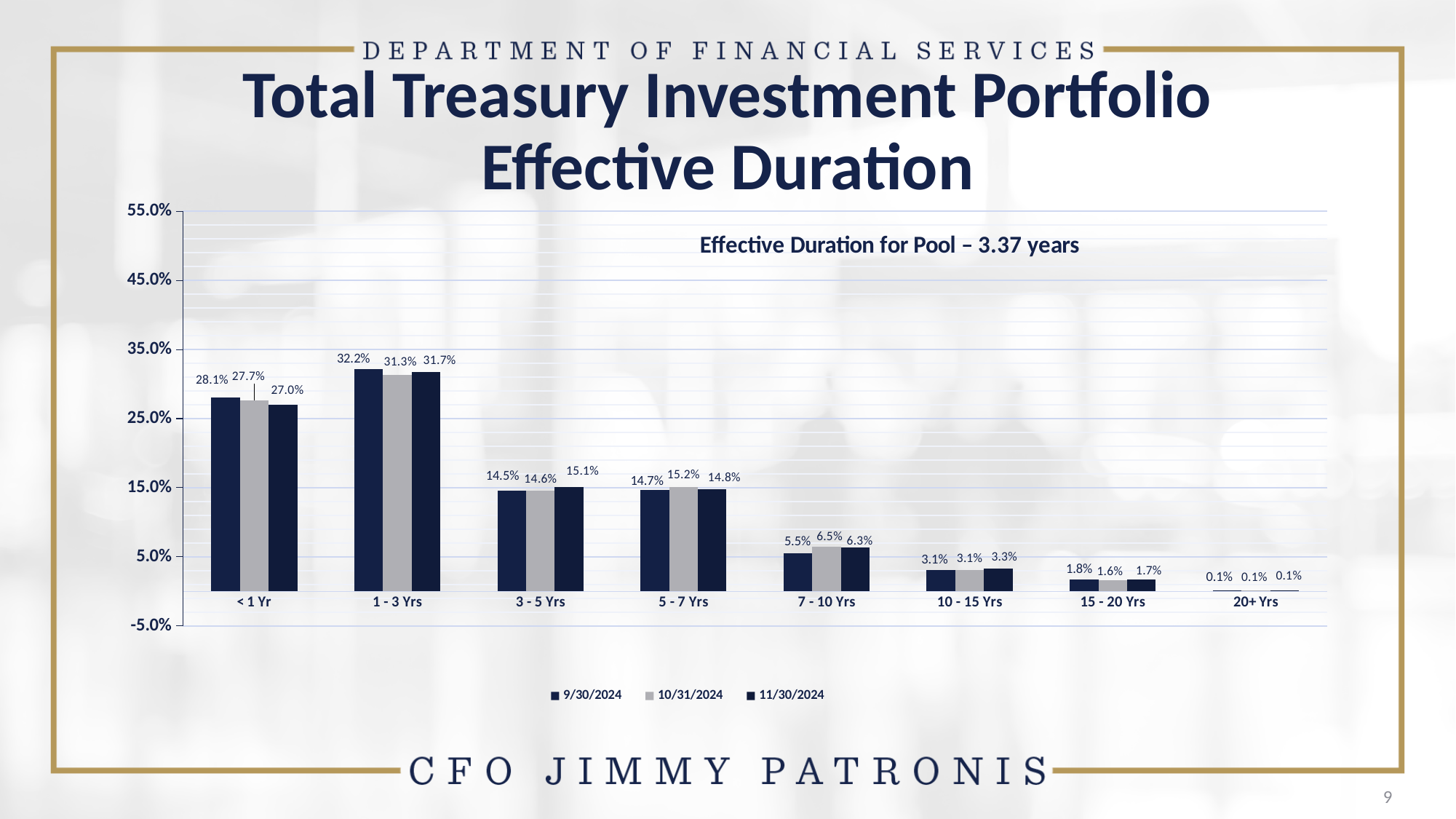
What is the difference between the 9/30/2024 and 11/30/2024 values for the < 1 Yr category? 1.1% Which is larger for the 3 - 5 Yrs category: the 9/30/2024 value or the 11/30/2024 value? 11/30/2024 How many series does the legend list? 3 Is the 10/31/2024 value for the 1 - 3 Yrs category greater or less than 25.0%? greater What is the value for the < 1 Yr category in the 11/30/2024 series? 27.0% What is the value for the 7 - 10 Yrs category in the 10/31/2024 series? 6.5% Which category has the lowest value in the 9/30/2024 series? 20+ Yrs What effective duration for the pool is stated on the chart? 3.37 years What is the value for the 1 - 3 Yrs category in the 9/30/2024 series? 32.2% What kind of chart is shown on the slide? bar chart How many categories are shown on the x axis? 8 Which category has the highest value in the 11/30/2024 series? 1 - 3 Yrs